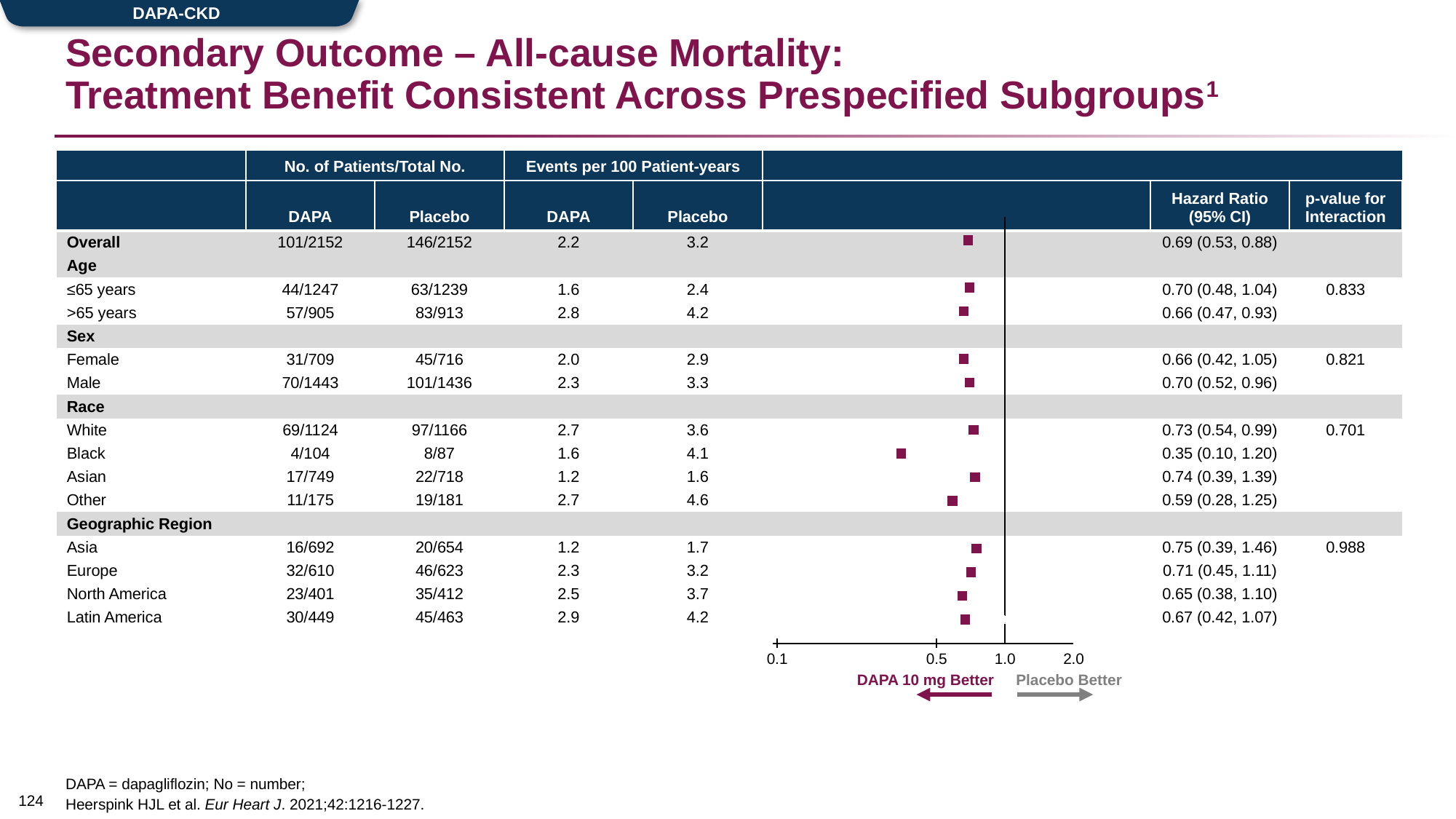
What is the hazard ratio (95% CI) for the Black subgroup? 0.35 (0.10, 1.20) Which subgroup has the lowest hazard ratio? Black Which has the higher hazard ratio, Female or Male? Male How many hazard ratio points are plotted in the forest plot? 13 Which direction on the x axis is labelled 'DAPA 10 mg Better'? Left (toward lower hazard ratios) What is the p-value for interaction for the Geographic Region subgroups? 0.988 What is the difference between the Placebo and DAPA events per 100 patient-years for the Overall population? 1.0 What is the hazard ratio (95% CI) for the Overall population? 0.69 (0.53, 0.88) What are the tick values shown on the x axis of the forest plot? 0.1, 0.5, 1.0, 2.0 What kind of chart is shown on the slide? Forest plot Is the hazard ratio point estimate for the Overall population greater or less than 1.0? less What is the number of patients with events out of the total for DAPA in the Latin America subgroup? 30/449